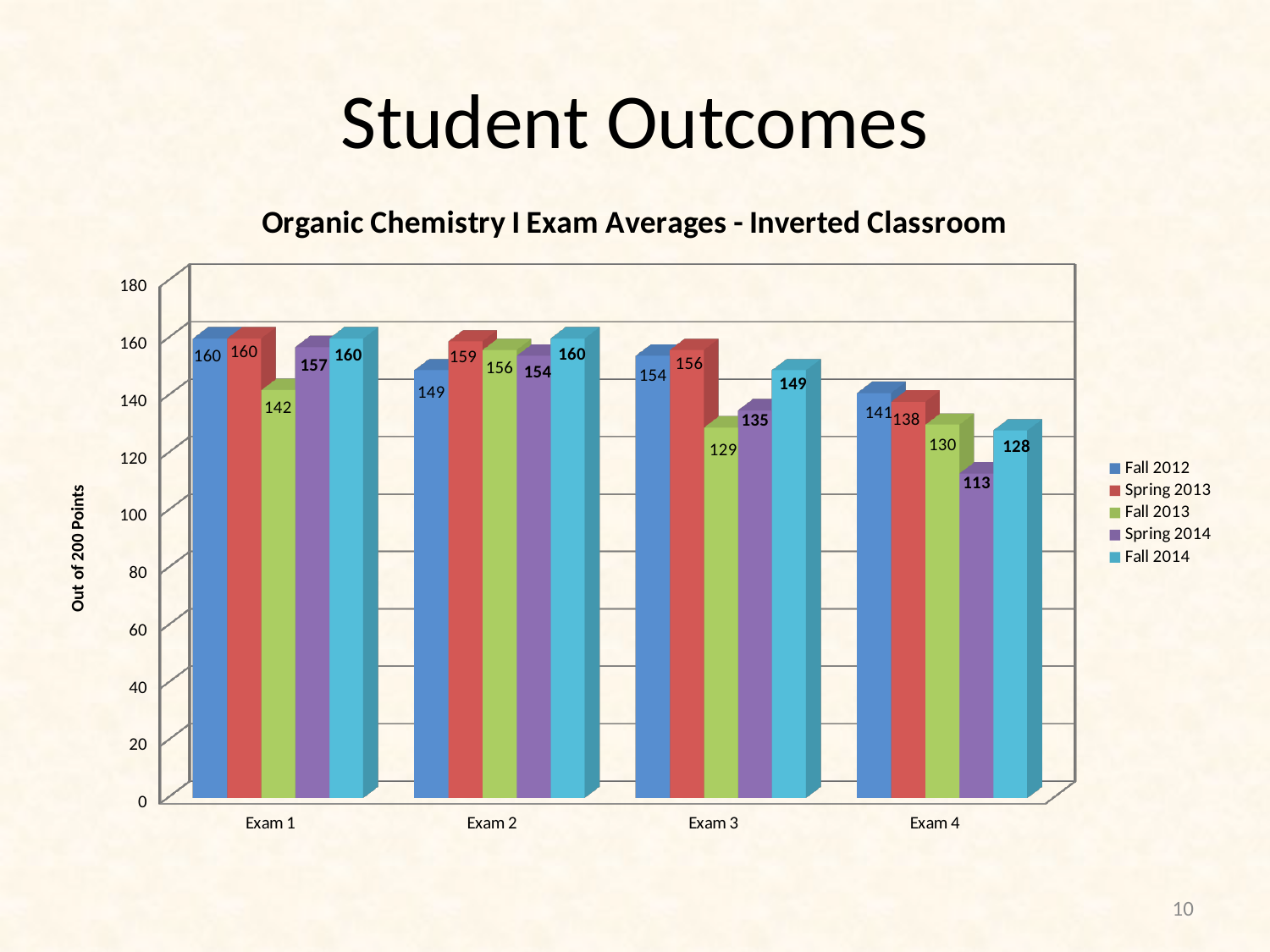
What is the difference between the Spring 2013 and Fall 2013 averages for Exam 3? 27 What is the label of the vertical axis? Out of 200 Points What is the Spring 2014 exam average for Exam 4? 113 How many series does the legend list? 5 What is the Fall 2014 exam average for Exam 3? 149 Which series has the lowest average for Exam 3? Fall 2013 What kind of chart is shown on the slide? Bar chart What is the Fall 2012 exam average for Exam 2? 149 Which series has the lowest average for Exam 4? Spring 2014 How many exams are shown on the x axis? 4 What is the Fall 2013 exam average for Exam 1? 142 Which is larger for Exam 2: the Fall 2012 average or the Fall 2014 average? Fall 2014